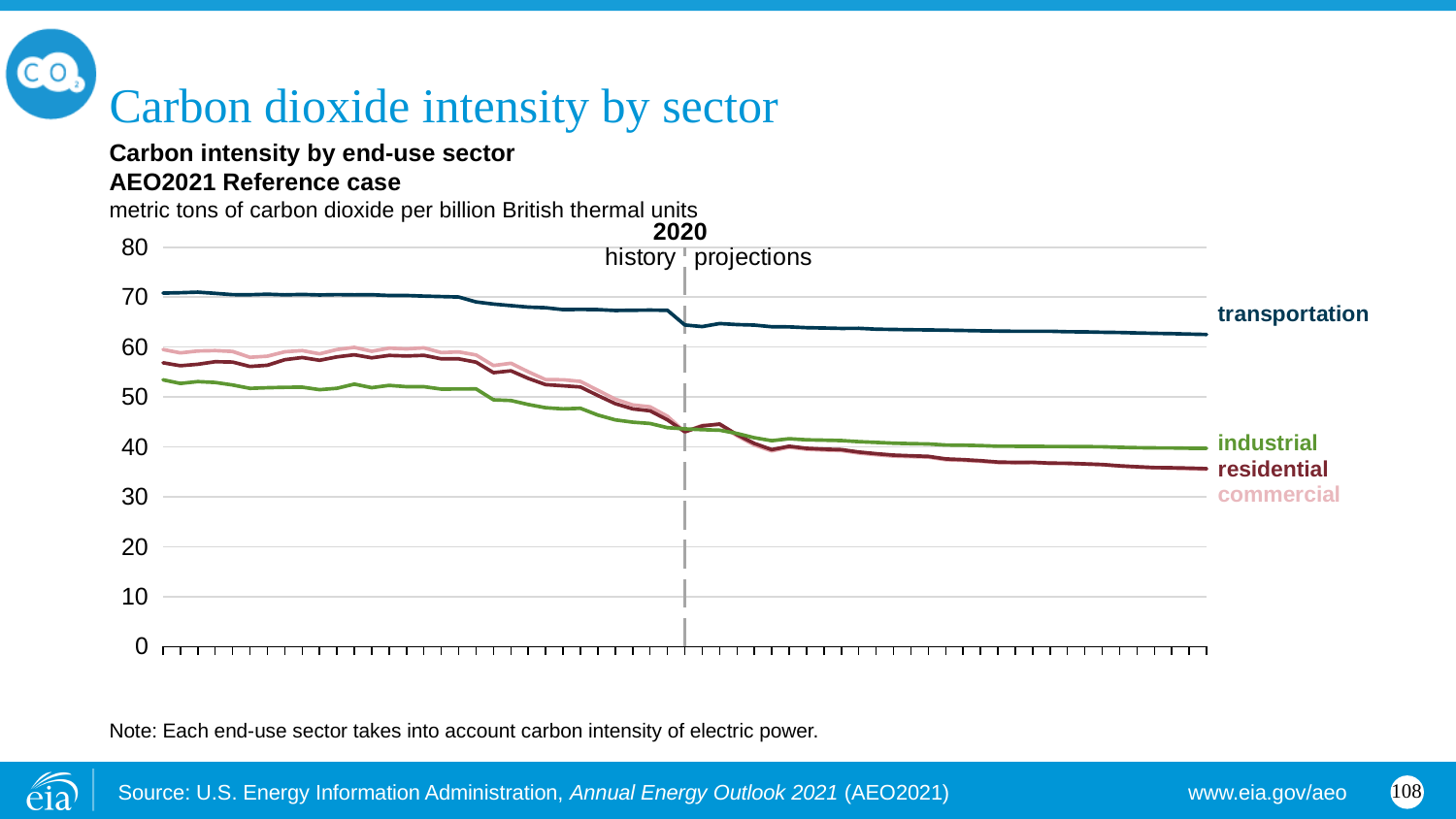
At the end of the projection period, which is larger: transportation or industrial? transportation What kind of chart is shown on the slide? line chart Does the carbon intensity for transportation rise or fall over the period shown? fall Is the value for residential at the end of the projection period greater or less than 40? less How many sectors (series) are plotted on the chart? 4 Is the value for transportation at the end of the projection period greater or less than 60? greater Is the value for commercial at the end of the projection period greater or less than 40? less Which sector has the lowest carbon intensity at the start of the history period? industrial What year separates history from projections on the chart? 2020 Which sector has the highest carbon intensity throughout the chart? transportation